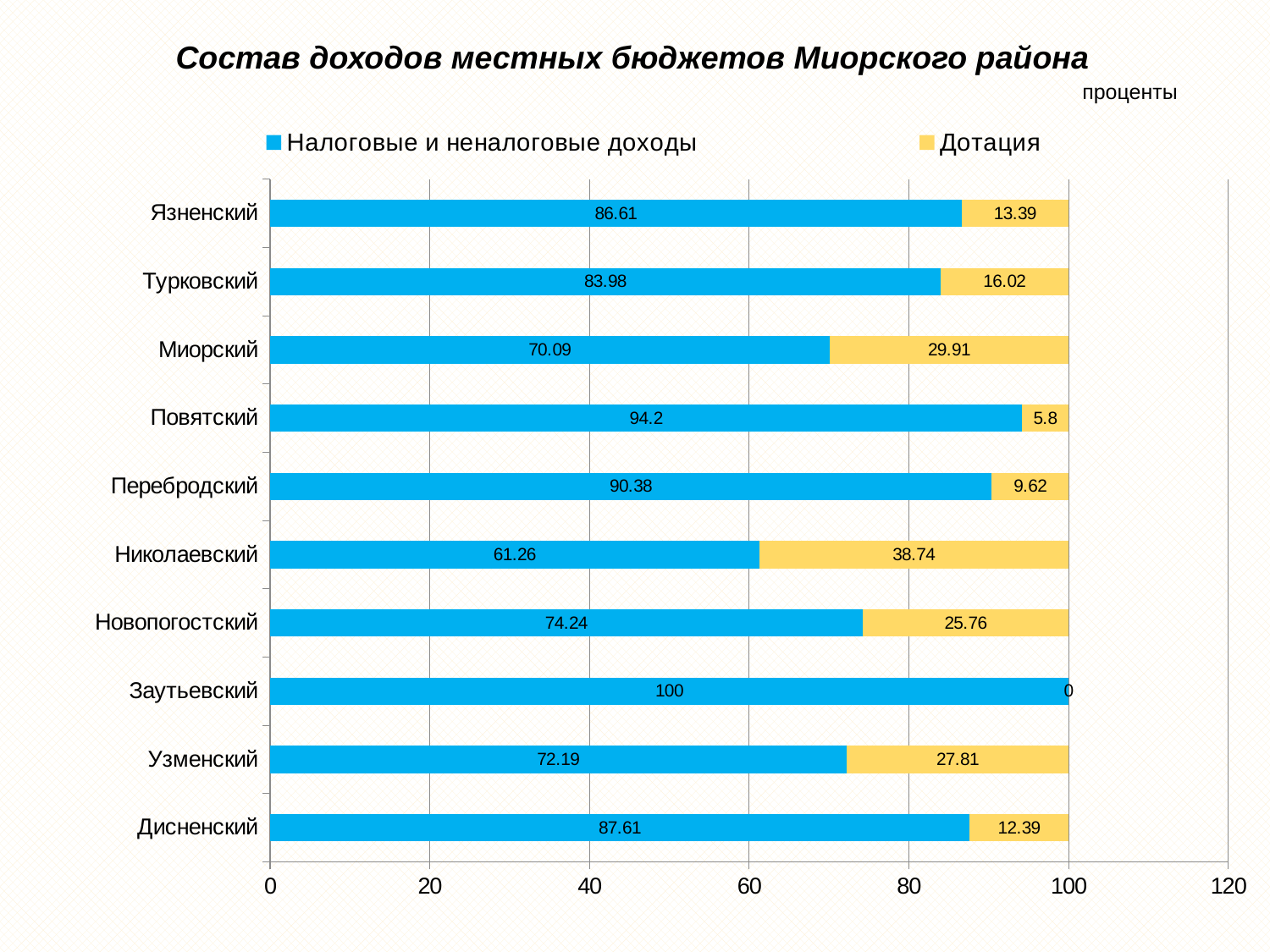
Which category has the highest value of Дотация? Николаевский What is the value of Дотация for Николаевский? 38.74 How many categories are shown on the chart? 10 What is the value of Налоговые и неналоговые доходы for Миорский? 70.09 What is the value of Дотация for Повятский? 5.8 Which is larger: the Налоговые и неналоговые доходы value for Турковский or for Дисненский? Дисненский Which category has the lowest value of Налоговые и неналоговые доходы? Николаевский What kind of chart is shown on the slide? Stacked bar chart What is the total of the stacked bar for Новопогостский? 100 What is the difference between the Дотация values for Миорский and Узменский? 2.1 How many series does the legend list? 2 Which category has the lowest value of Дотация? Заутьевский